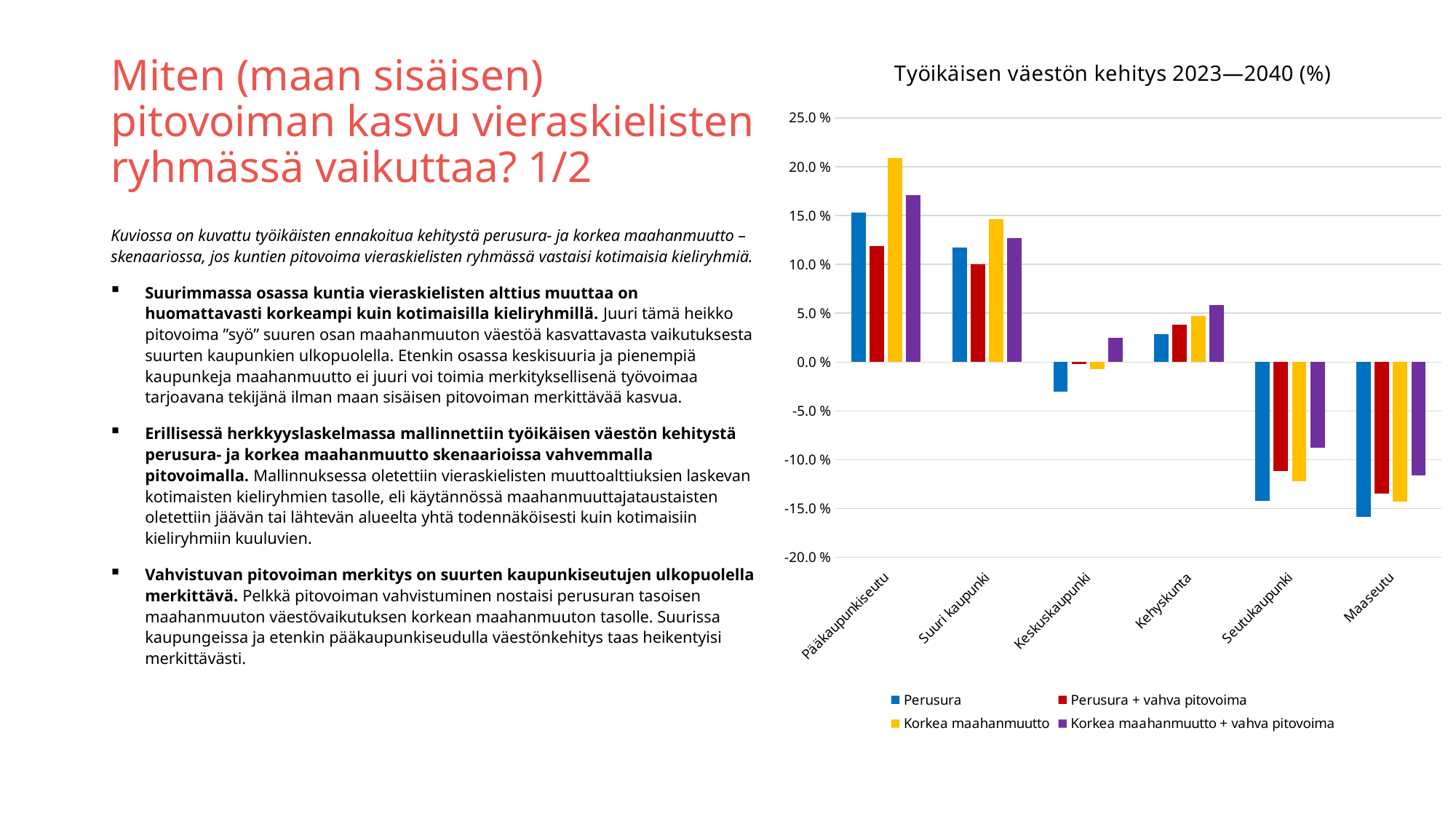
Is the Korkea maahanmuutto value for Pääkaupunkiseutu greater or less than 20.0 %? greater How many categories are shown on the x axis of the chart? 6 What kind of chart is shown on the slide? bar chart How many series does the chart's legend list? 4 Is the Perusura value for Maaseutu greater or less than -15.0 %? less Which category has the lowest value for the Perusura series? Maaseutu For Seutukaupunki, which is larger: the Perusura value or the Korkea maahanmuutto + vahva pitovoima value? Korkea maahanmuutto + vahva pitovoima Which category has the highest value for the Korkea maahanmuutto series? Pääkaupunkiseutu Which is larger: the Perusura value for Pääkaupunkiseutu or the Perusura value for Suuri kaupunki? Pääkaupunkiseutu What is the title of the chart? Työikäisen väestön kehitys 2023—2040 (%) What colour represents the Perusura series in the chart? blue Is the Perusura value for Suuri kaupunki greater or less than 10.0 %? greater